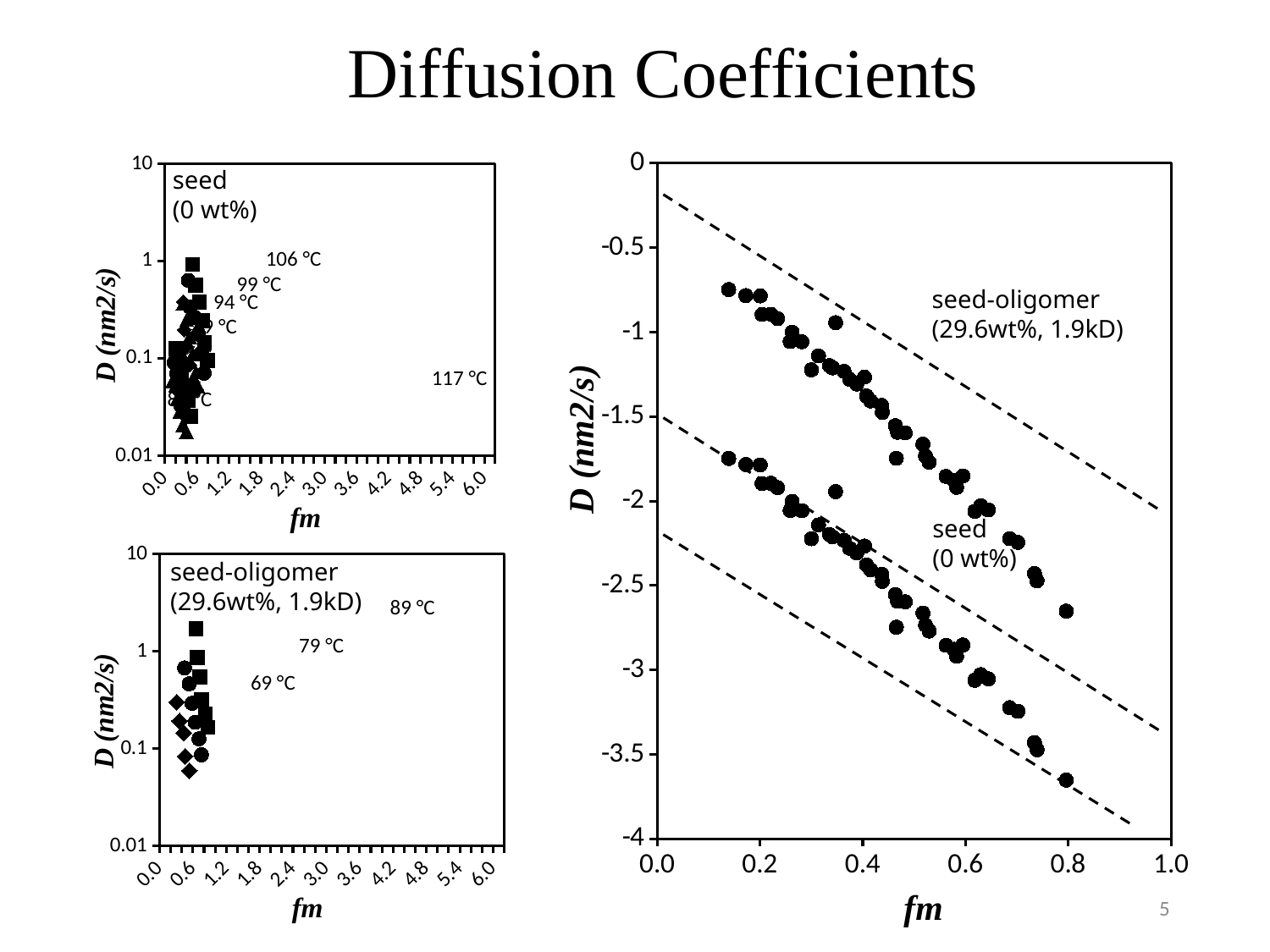
How many dashed lines are drawn on the right-hand chart? 3 In the right-hand chart, is the seed (0 wt%) value at fm = 0.8 greater or less than -3.5? less In the right-hand chart, do the D values rise or fall as fm increases? fall In the right-hand chart, which series has the higher D values, seed-oligomer (29.6wt%, 1.9kD) or seed (0 wt%)? seed-oligomer (29.6wt%, 1.9kD) In the right-hand chart, is the seed-oligomer value at fm = 0.8 greater or less than -2.5? less In the right-hand chart, is the seed (0 wt%) value at fm = 0.2 greater or less than -2? greater What kind of chart is the large chart on the right of the slide? scatter chart What is the label on the y axis of the bottom-left chart? D (nm2/s) How many charts are shown on the slide? 3 What kind of chart is the top-left chart labelled 'seed (0 wt%)'? scatter chart What is the label on the x axis of the right-hand chart? fm